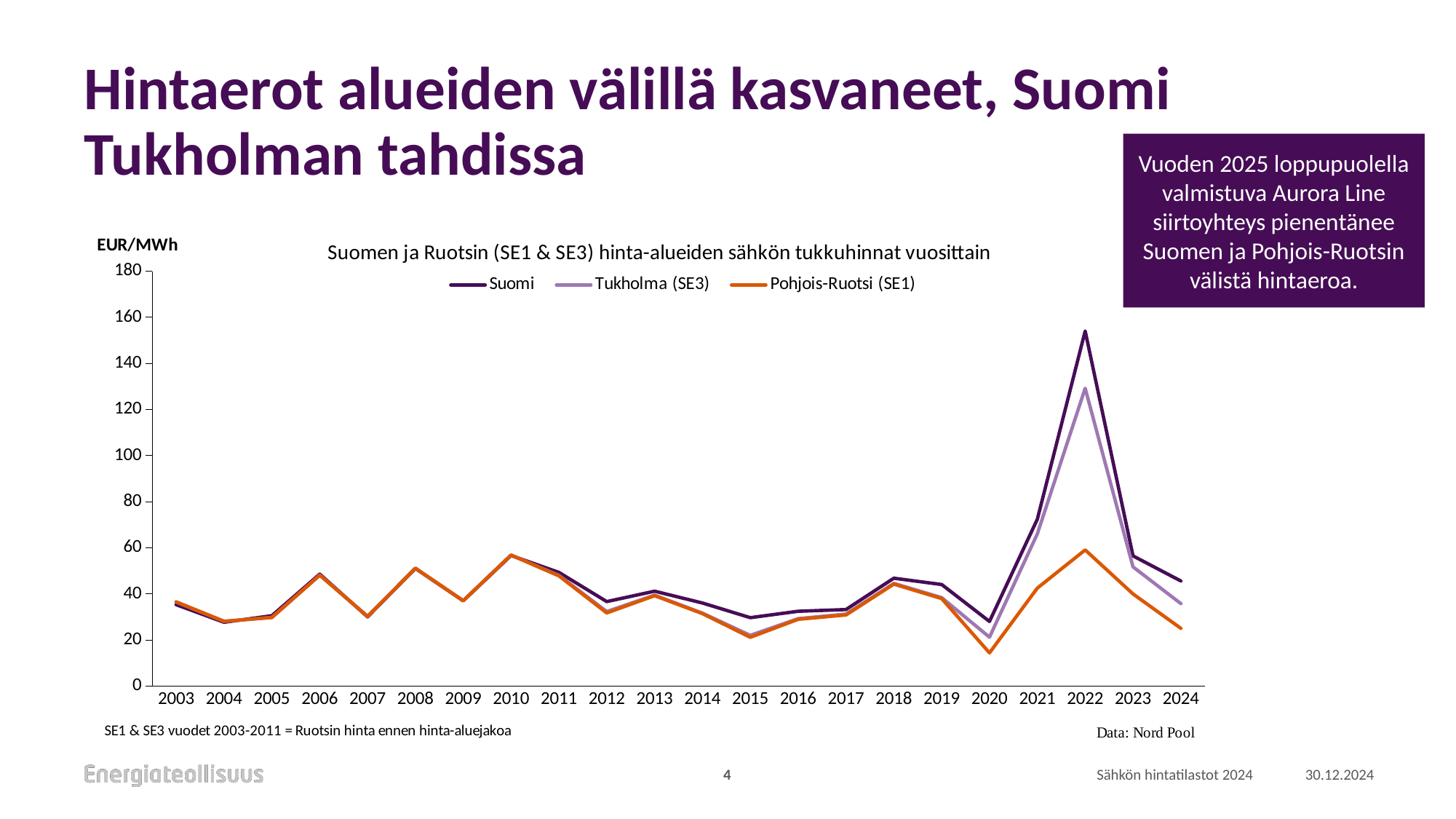
In 2022, which series has the larger value, Suomi or Pohjois-Ruotsi (SE1)? Suomi What kind of chart is shown on the slide? line chart How many years are plotted along the x axis of the chart? 22 Is the value for Tukholma (SE3) in 2022 greater or less than 120? greater How many series does the chart legend list? 3 Is the value for Pohjois-Ruotsi (SE1) in 2020 greater or less than 20? less In which year does the Suomi series reach its highest value? 2022 What unit is shown on the y axis of the chart? EUR/MWh Is the value for Suomi in 2024 greater or less than 60? less In which year does the Pohjois-Ruotsi (SE1) series reach its lowest value? 2020 Does the Suomi series rise or fall from 2022 to 2024? fall